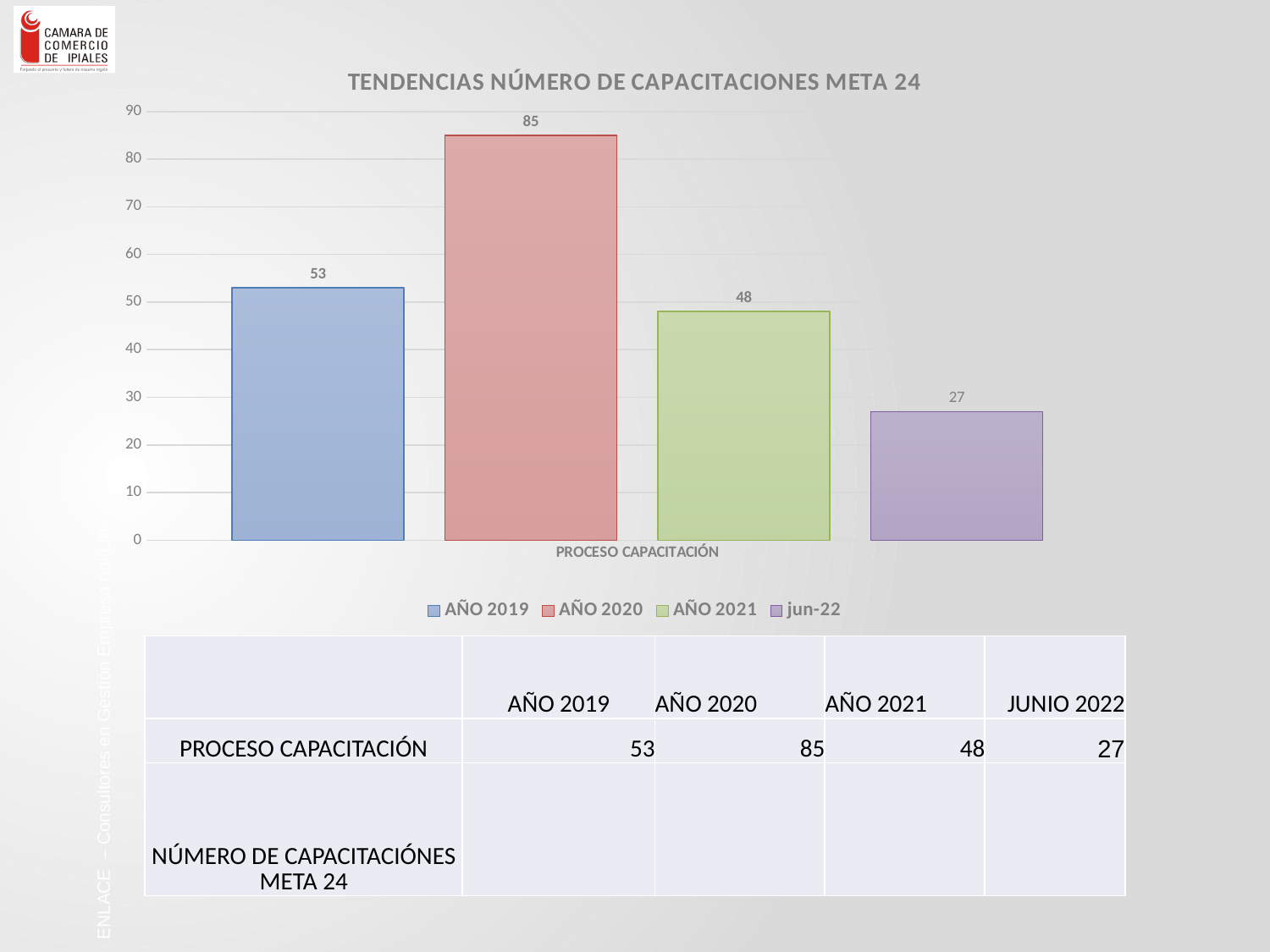
How many series does the legend list? 4 What is the value for jun-22? 27 What is the value for AÑO 2020? 85 Which series has the highest value? AÑO 2020 What is the value for AÑO 2021? 48 What is the difference between the values for AÑO 2020 and AÑO 2019? 32 Which is larger, the value for AÑO 2019 or the value for AÑO 2021? AÑO 2019 What is the value for AÑO 2019? 53 What is the difference between the values for AÑO 2021 and jun-22? 21 What is the title of the chart? TENDENCIAS NÚMERO DE CAPACITACIONES META 24 Which series has the lowest value? jun-22 What kind of chart is shown on the slide? Bar chart